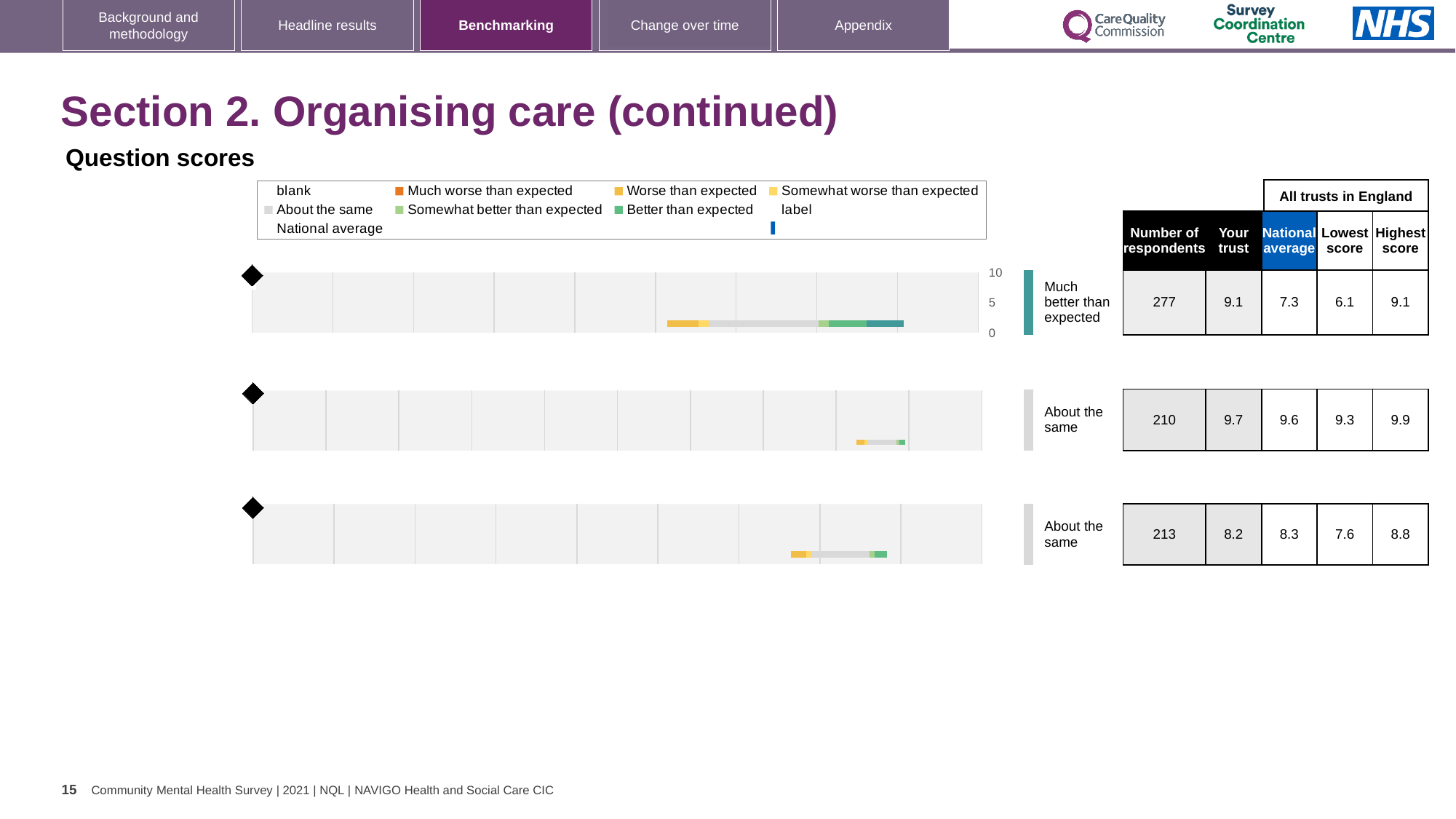
What kind of chart is used for the three benchmarking rows on the slide? bar chart For the top chart (labelled 'Much better than expected'), what is the national average score? 7.3 How many benchmarking charts are shown on the slide? 3 What benchmark category label is shown next to the top chart? Much better than expected For the top chart (labelled 'Much better than expected'), what is the 'Your trust' score? 9.1 For the second chart, how many respondents are listed? 210 For the second chart, what is the highest score among all trusts in England? 9.9 For the third (bottom) chart, which is larger: the 'Your trust' score or the national average? National average For the third (bottom) chart, what is the 'Your trust' score? 8.2 What is the highest tick value on the vertical axis of the top chart? 10 For the top chart, what is the difference between the 'Your trust' score and the national average? 1.8 Which of the three charts has the highest 'Your trust' score? The second chart (9.7)